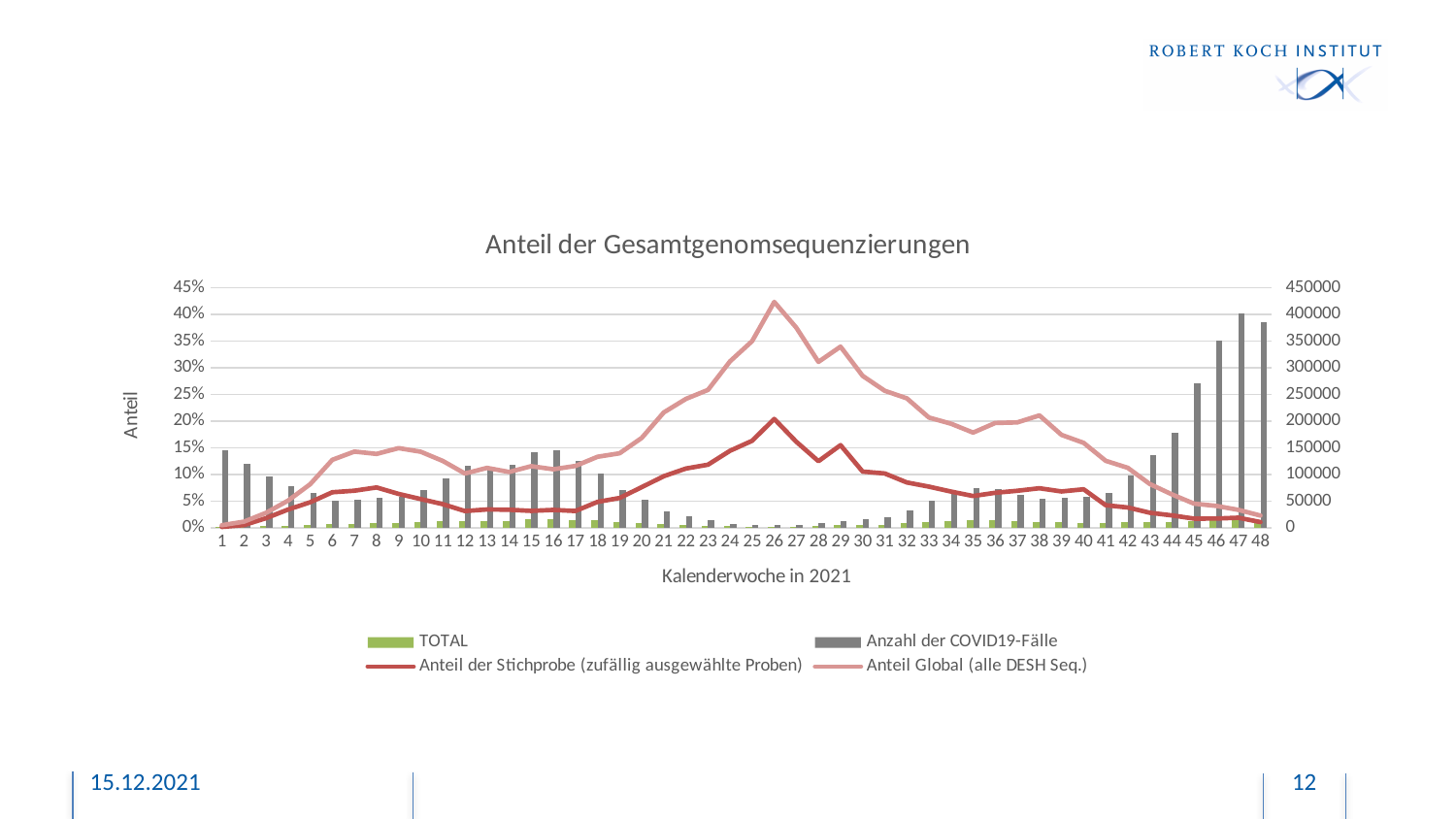
Does the 'Anteil Global (alle DESH Seq.)' line rise or fall from calendar week 26 to calendar week 48? fall Is the value of 'Anteil Global (alle DESH Seq.)' in calendar week 26 greater or less than 40%? greater What kind of chart is shown on the slide? Combined bar and line chart Is the 'Anzahl der COVID19-Fälle' bar in calendar week 47 greater or less than 350000? greater In which calendar week does the 'Anteil der Stichprobe (zufällig ausgewählte Proben)' line reach its highest value? 26 What is the title of the chart? Anteil der Gesamtgenomsequenzierungen Is the value of 'Anteil der Stichprobe (zufällig ausgewählte Proben)' in calendar week 26 greater or less than 15%? greater In which calendar week does the 'Anteil Global (alle DESH Seq.)' line reach its highest value? 26 How many series does the legend list? 4 In calendar week 26, which is larger: 'Anteil Global (alle DESH Seq.)' or 'Anteil der Stichprobe (zufällig ausgewählte Proben)'? Anteil Global (alle DESH Seq.) How many calendar weeks are shown on the x axis? 48 Do the 'Anzahl der COVID19-Fälle' bars rise or fall from calendar week 40 to calendar week 47? rise